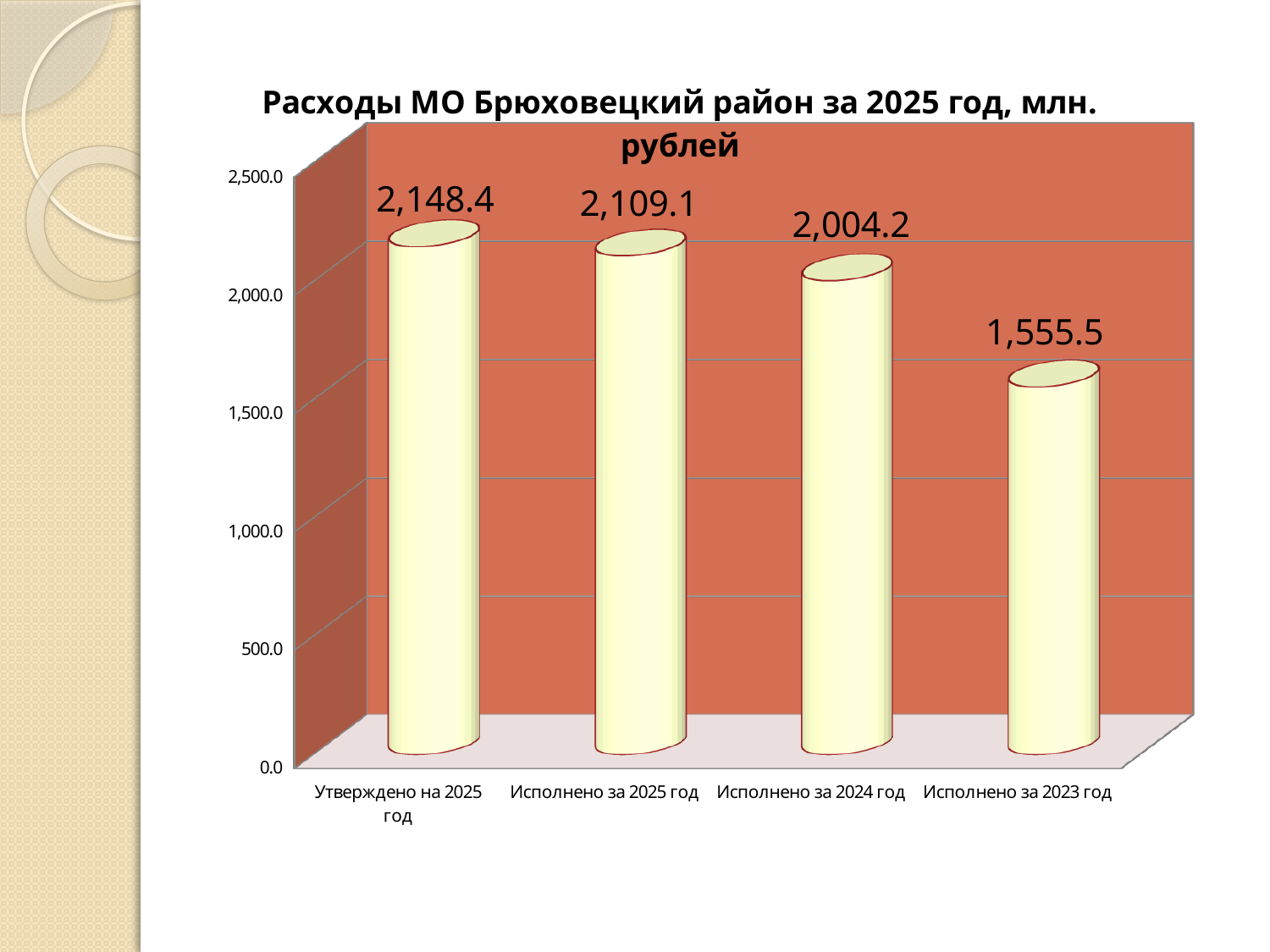
Which category has the highest value? Утверждено на 2025 год How many categories are shown in the chart? 4 Which category has the lowest value? Исполнено за 2023 год Is the value for "Исполнено за 2023 год" greater or less than 2,000.0? less What kind of chart is shown on the slide? Bar chart What is the difference between "Утверждено на 2025 год" and "Исполнено за 2025 год"? 39.3 What is the value for "Утверждено на 2025 год"? 2,148.4 What is the value for "Исполнено за 2024 год"? 2,004.2 What is the value for "Исполнено за 2023 год"? 1,555.5 Which is larger, the value for "Исполнено за 2025 год" or the value for "Исполнено за 2024 год"? Исполнено за 2025 год Do the values rise or fall from left to right along the x axis? Fall What is the difference between "Исполнено за 2024 год" and "Исполнено за 2023 год"? 448.7